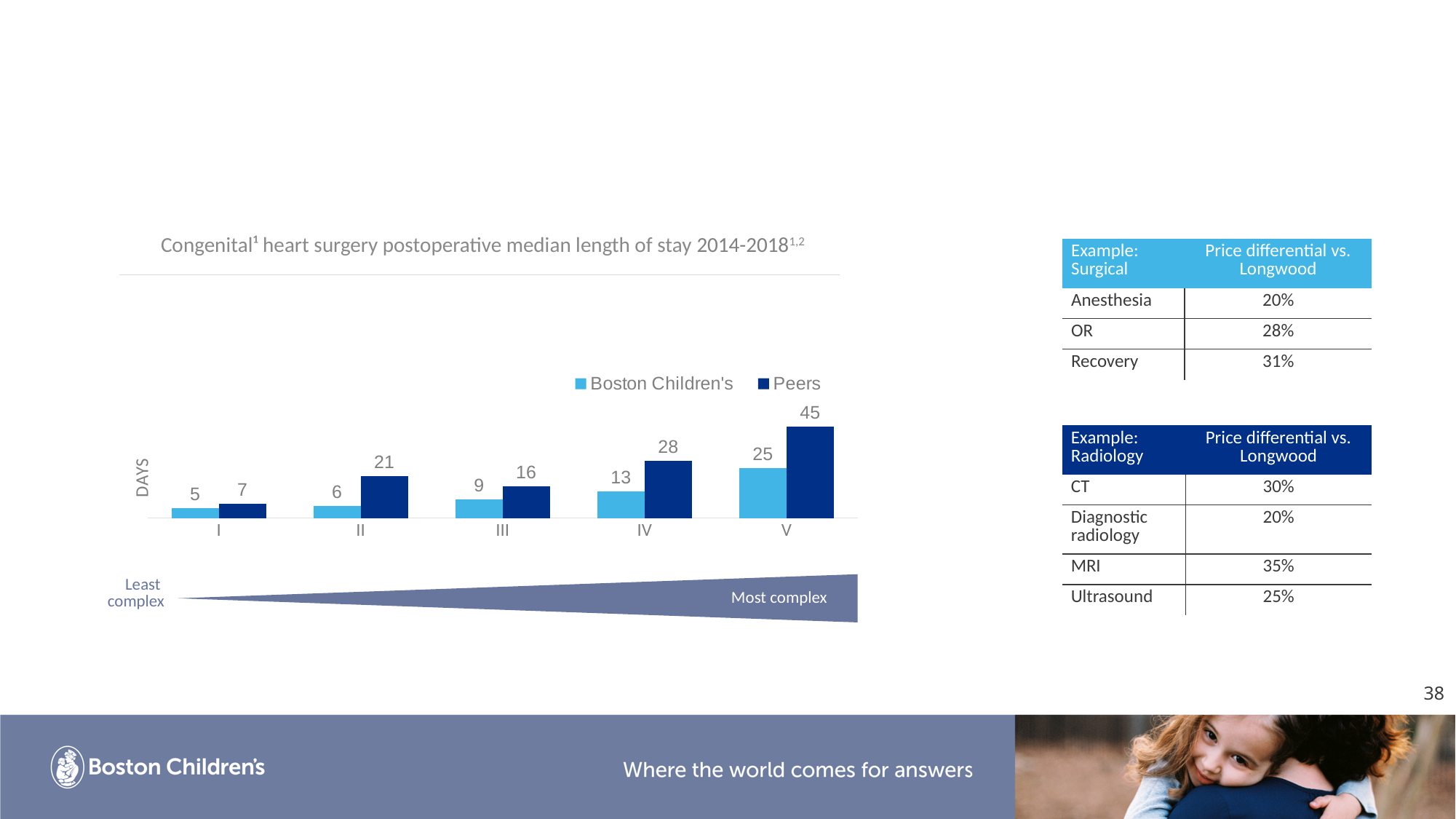
What is the Boston Children's value for category IV? 13 Which category has the highest Peers value? V Which category has the lowest Boston Children's value? I What is the difference between the Peers and Boston Children's values for category III? 7 How many series does the legend list? 2 Do the Boston Children's values rise or fall from category I to category V? Rise How many categories are shown on the x axis? 5 What is the Peers value for category II? 21 What kind of chart is shown? Bar chart What is the Peers value for category V? 45 What is the difference between the Peers and Boston Children's values for category V? 20 Which is larger for category IV, the Boston Children's value or the Peers value? Peers